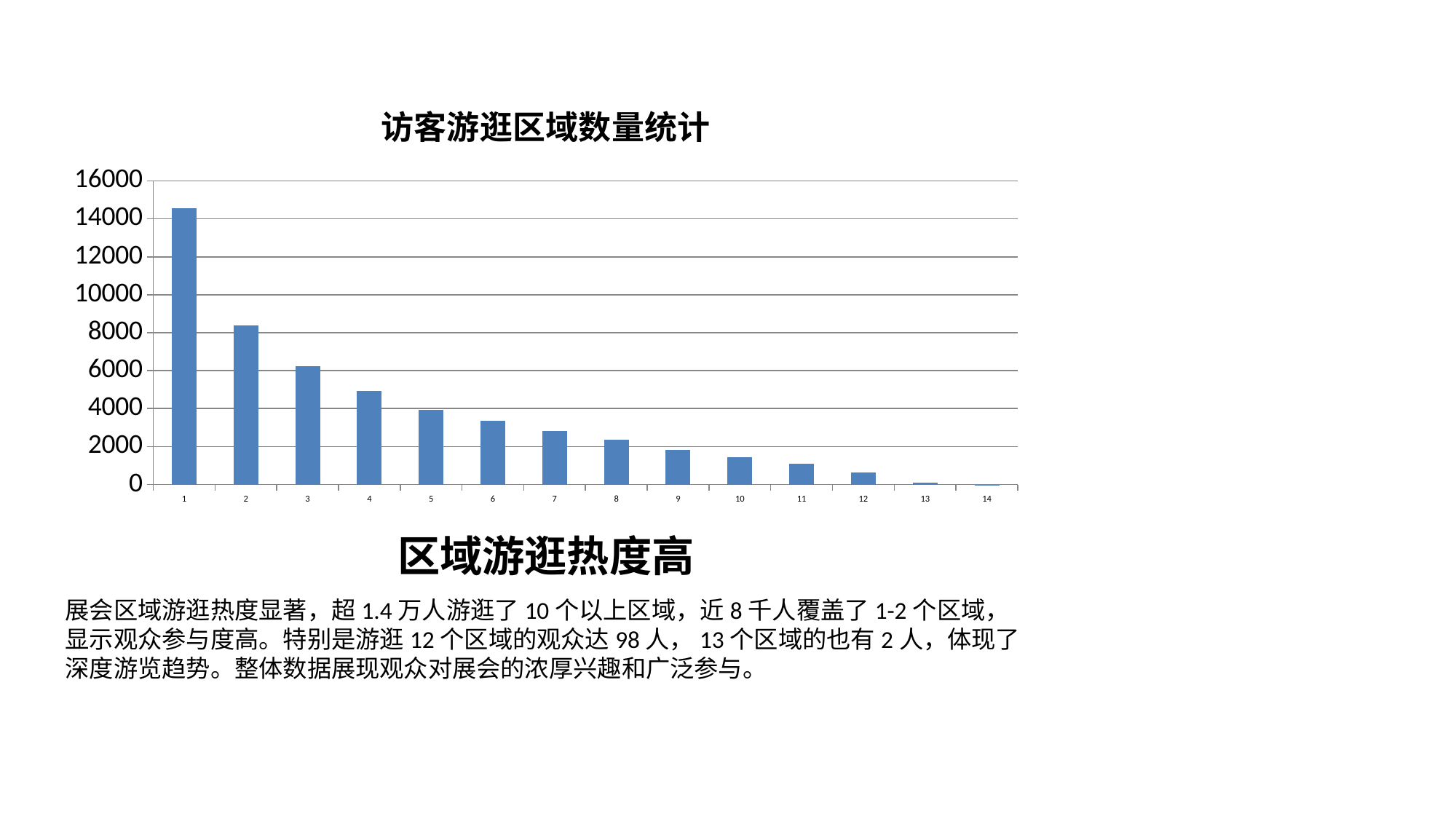
Is the value for category 9 greater or less than 2000? less Do the values rise or fall as you move from category 1 to category 14 along the x axis? fall Is the value for category 6 greater or less than 4000? less Is the value for category 1 greater or less than 14000? greater Which has the larger value, category 10 or category 12? 10 Which has the larger value, category 3 or category 4? 3 What kind of chart is shown on the slide? bar chart How many categories are shown on the x axis of the chart? 14 Which category has the highest value in the chart? 1 What is the title of the chart? 访客游逛区域数量统计